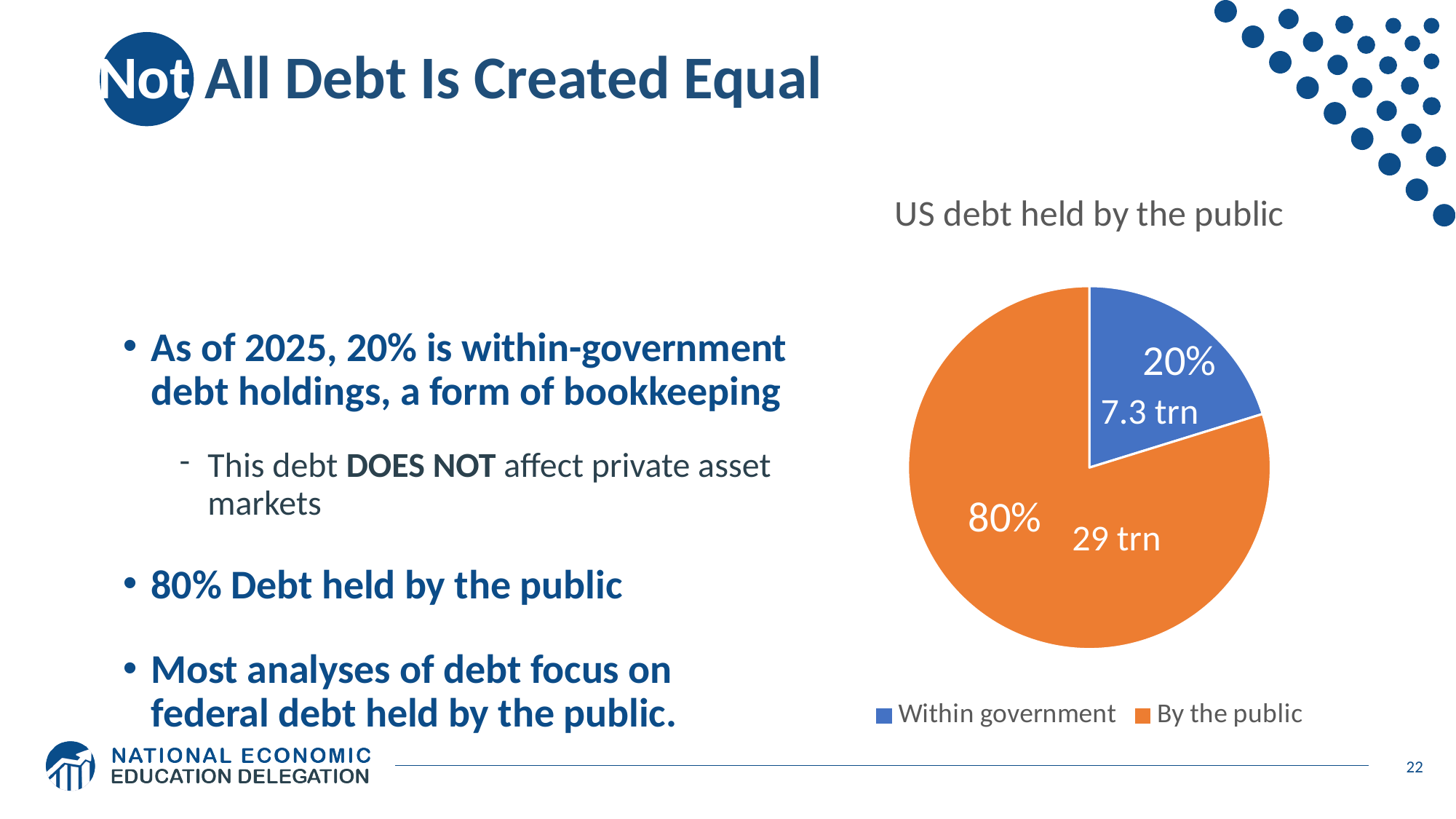
What share of the pie is held within government? 20% What value is labelled on the 'By the public' slice? 29 trn Which slice of the pie is the smallest? Within government What share of the pie is held by the public? 80% What kind of chart is shown on the slide? Pie chart What value is labelled on the 'Within government' slice? 7.3 trn Which is larger, the 'Within government' slice or the 'By the public' slice? By the public How many slices does the pie chart have? 2 Which slice of the pie is the largest? By the public What colour is the 'By the public' slice? Orange What is the title of the chart? US debt held by the public How many entries does the legend list? 2